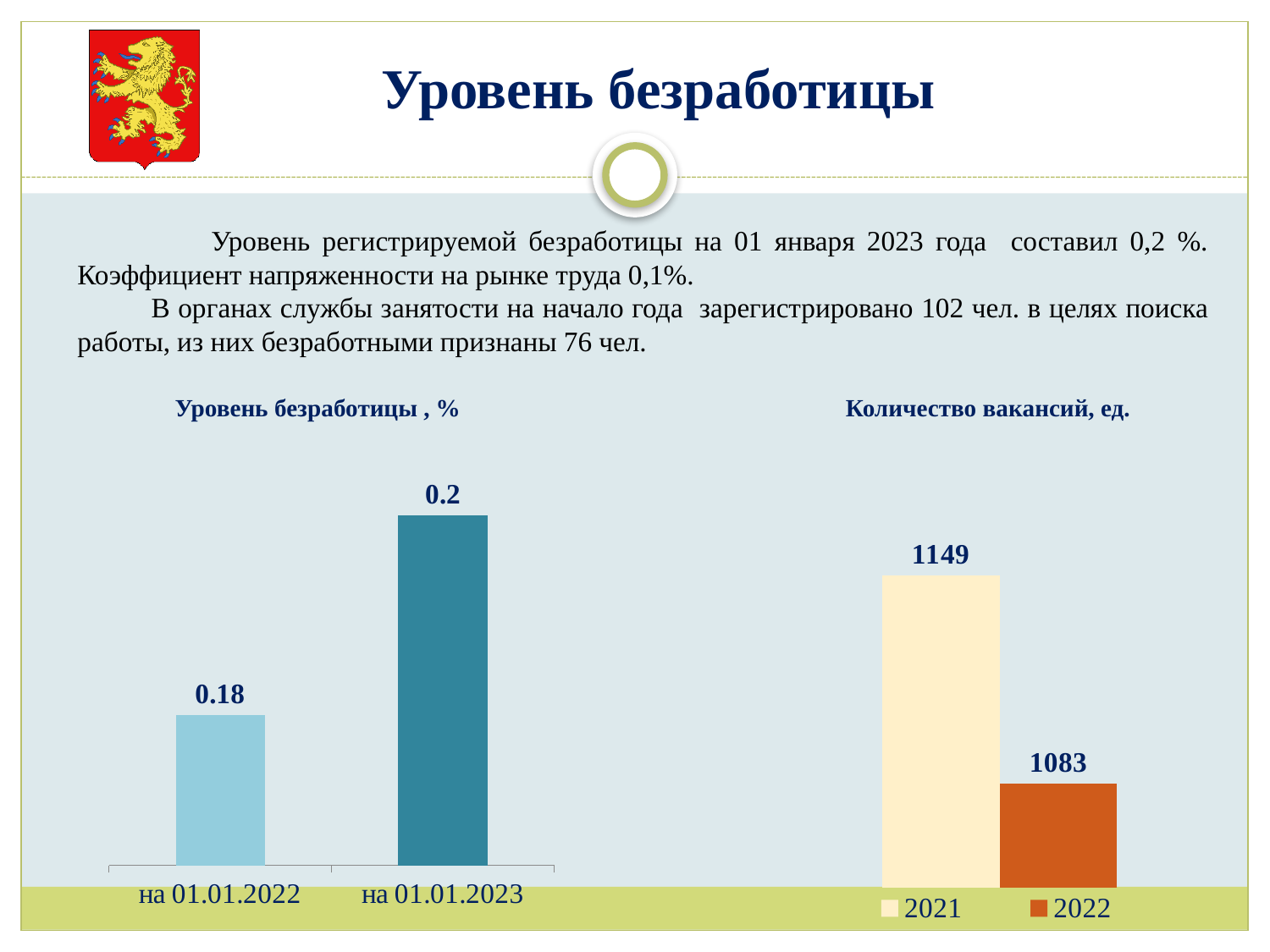
In the chart titled "Уровень безработицы , %", do the values rise or fall from "на 01.01.2022" to "на 01.01.2023"? rise In the chart titled "Уровень безработицы , %", which category has the higher value? на 01.01.2023 In the chart titled "Уровень безработицы , %", how many bars are plotted? 2 In the chart titled "Количество вакансий, ед.", which year has the lower value? 2022 In the chart titled "Количество вакансий, ед.", what is the difference between the 2021 and 2022 values? 66 In the chart titled "Количество вакансий, ед.", what is the value for 2021? 1149 What kind of chart is the chart titled "Количество вакансий, ед."? bar chart In the chart titled "Уровень безработицы , %", what is the value for "на 01.01.2023"? 0.2 In the chart titled "Количество вакансий, ед.", what is the value for 2022? 1083 In the chart titled "Уровень безработицы , %", what is the value for "на 01.01.2022"? 0.18 In the chart titled "Количество вакансий, ед.", which colour represents 2022 in the legend? orange In the chart titled "Количество вакансий, ед.", how many entries does the legend list? 2